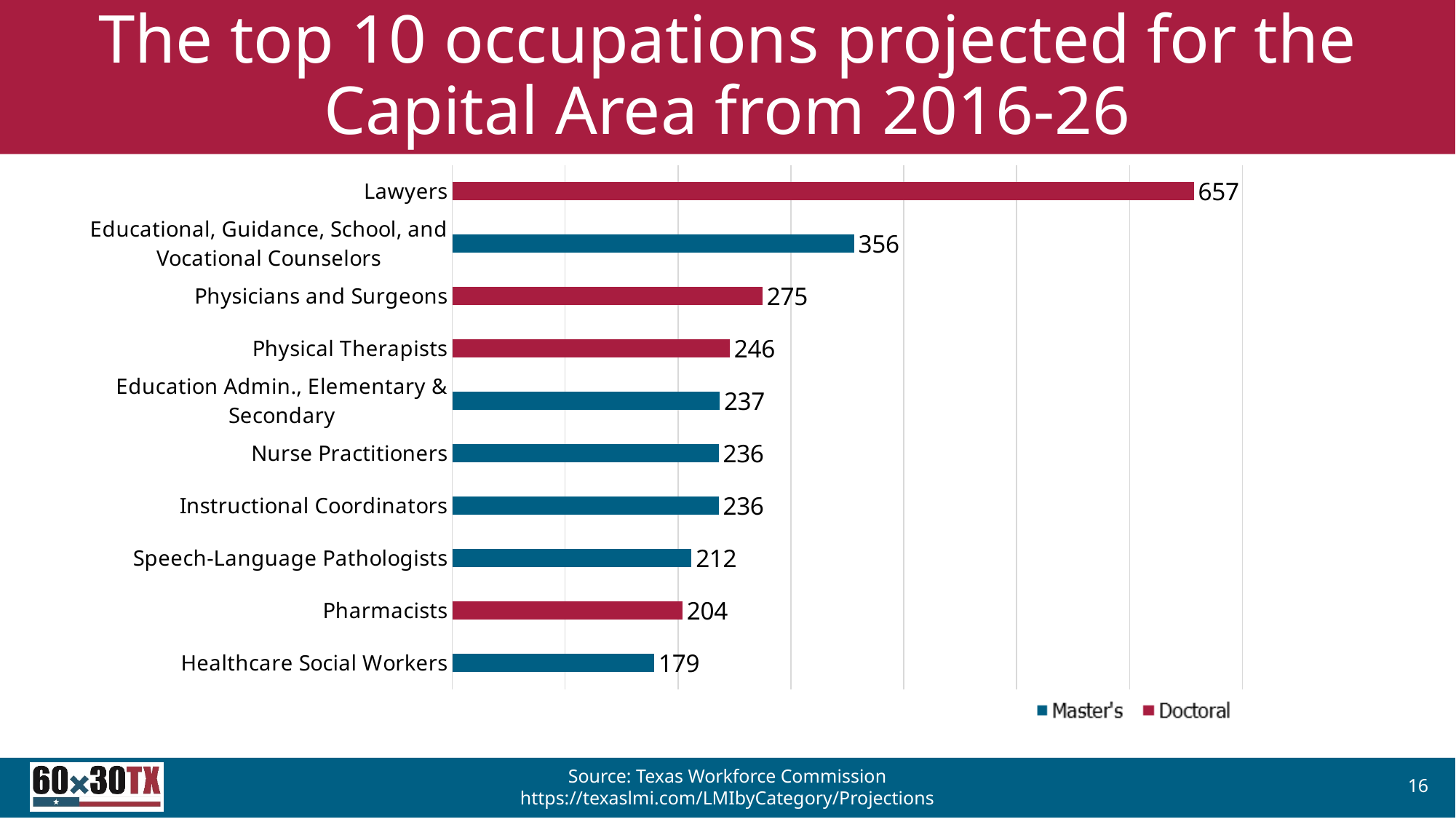
What is the value for Lawyers? 657 What is the value for Speech-Language Pathologists? 212 What is the value for Physicians and Surgeons? 275 What is the difference between the values for Lawyers and Educational, Guidance, School, and Vocational Counselors? 301 How many series does the legend list? 2 How many occupations are shown in the chart? 10 What kind of chart is shown on the slide? Bar chart What is the difference between the values for Physical Therapists and Pharmacists? 42 Which occupation has the lowest value? Healthcare Social Workers Which is larger, the value for Physical Therapists or the value for Pharmacists? Physical Therapists Which series does the Pharmacists bar belong to, according to the legend? Doctoral Which occupation has the highest value? Lawyers